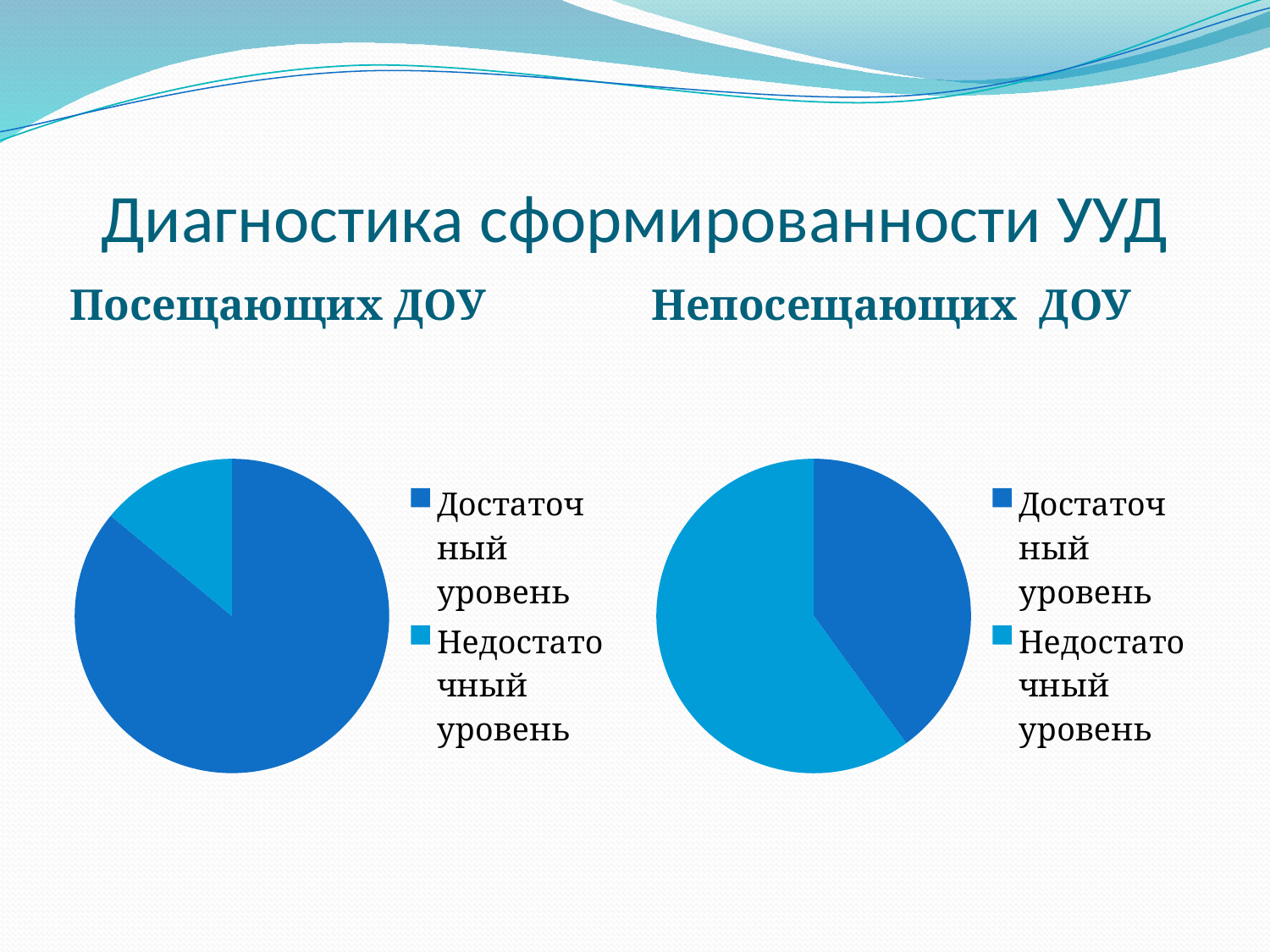
In the "Посещающих ДОУ" chart, how many categories does the legend list? 2 In the "Непосещающих ДОУ" chart, which category has the smallest slice? Достаточный уровень In the "Непосещающих ДОУ" chart, which slice is larger: "Достаточный уровень" or "Недостаточный уровень"? Недостаточный уровень In the "Посещающих ДОУ" chart, which category has the largest slice? Достаточный уровень In the "Посещающих ДОУ" chart, which slice is larger: "Достаточный уровень" or "Недостаточный уровень"? Достаточный уровень What kind of chart is shown under the heading "Посещающих ДОУ"? pie chart In the "Непосещающих ДОУ" chart, how many categories does the legend list? 2 What is the main title of the slide above the two charts? Диагностика сформированности УУД In the "Непосещающих ДОУ" chart, which category has the largest slice? Недостаточный уровень What kind of chart is shown under the heading "Непосещающих ДОУ"? pie chart In the "Посещающих ДОУ" chart, which category has the smallest slice? Недостаточный уровень How many pie charts are shown on the slide? 2